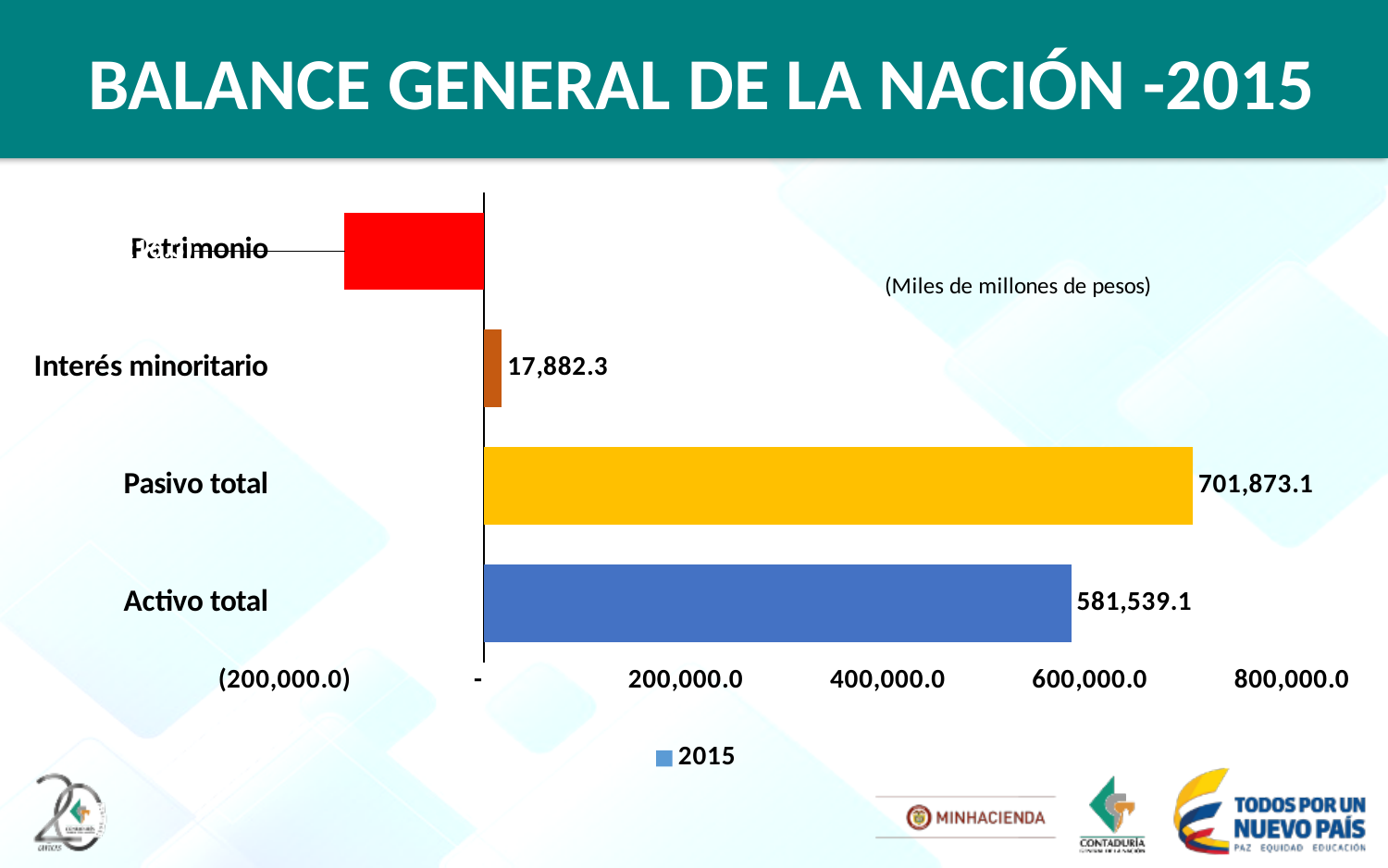
Which category has the highest value? Pasivo total Is the value for Patrimonio greater or less than 0? less What is the value for Pasivo total? 701,873.1 How many series does the legend list? 1 What kind of chart is shown on the slide? bar chart Which is larger, Activo total or Pasivo total? Pasivo total What is the difference between Pasivo total and Activo total? 120,334.0 What is the value for Activo total? 581,539.1 What unit is stated for the values in the chart? Miles de millones de pesos Which category has the lowest value? Patrimonio What is the value for Interés minoritario? 17,882.3 How many categories are shown in the chart? 4